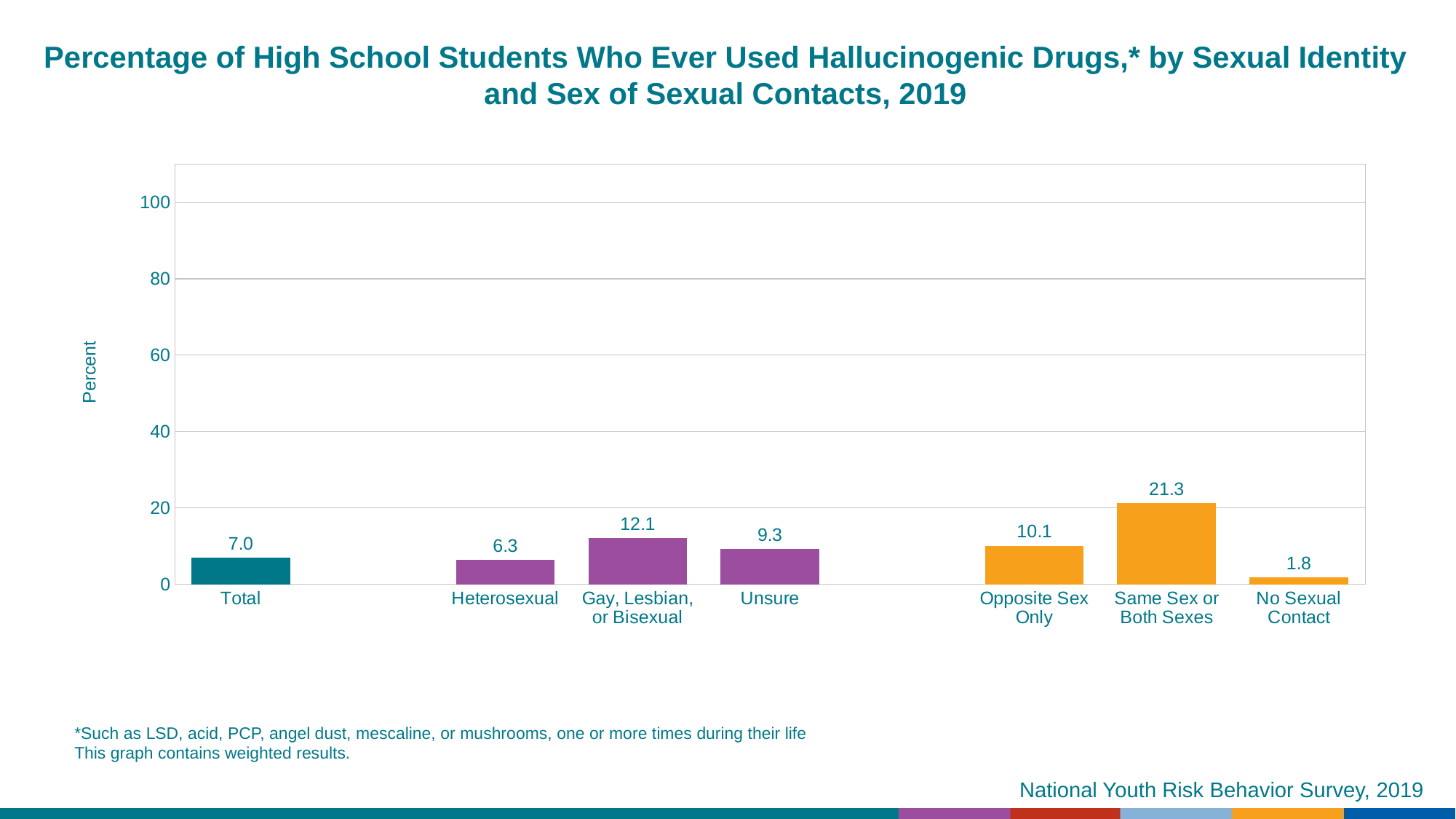
Is the value for Same Sex or Both Sexes greater or less than 20? greater What is the value for students with No Sexual Contact? 1.8 What is the value for Total? 7.0 Which is larger, the value for Unsure or the value for Heterosexual? Unsure What is the value for Gay, Lesbian, or Bisexual students? 12.1 How many categories are shown on the chart? 7 What is the label of the y axis? Percent Which category has the highest value? Same Sex or Both Sexes What is the value for Heterosexual students? 6.3 What kind of chart is this? Bar chart Which category has the lowest value? No Sexual Contact What is the difference between the values for Same Sex or Both Sexes and Opposite Sex Only? 11.2